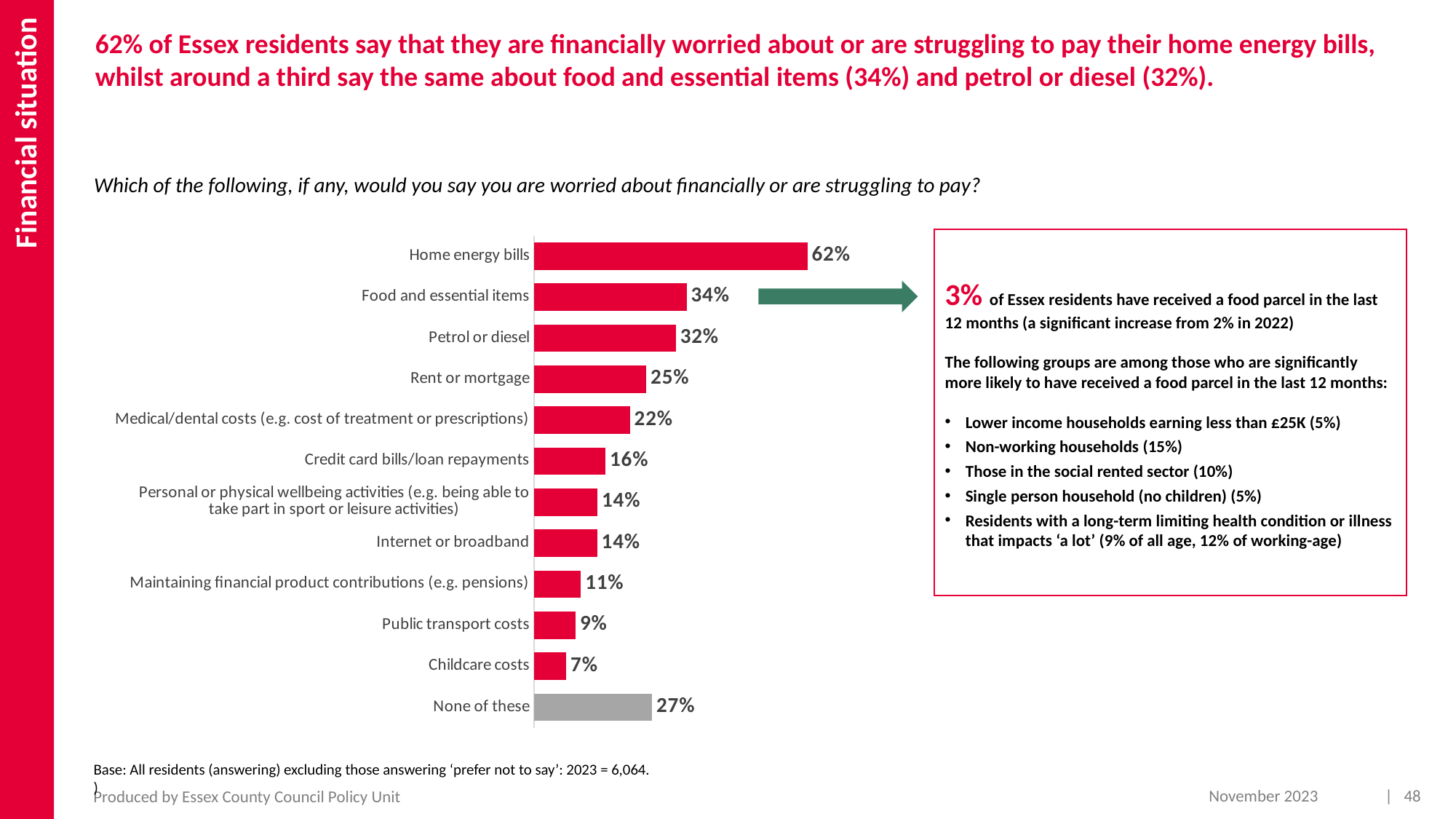
What is the value shown for None of these? 27% What is the difference between the values for Food and essential items and Petrol or diesel? 2% What is the value shown for Rent or mortgage? 25% What type of chart is shown on the slide? Bar chart What percentage of residents say they are worried about or struggling to pay home energy bills? 62% Which category has the highest value in the chart? Home energy bills Which is larger, the value for Credit card bills/loan repayments or the value for Public transport costs? Credit card bills/loan repayments What is the value shown for Childcare costs? 7% Which bar in the chart is coloured grey rather than red? None of these How many categories are shown in the bar chart? 12 What is the difference between the values for Home energy bills and Rent or mortgage? 37% Which category has the lowest value in the chart? Childcare costs